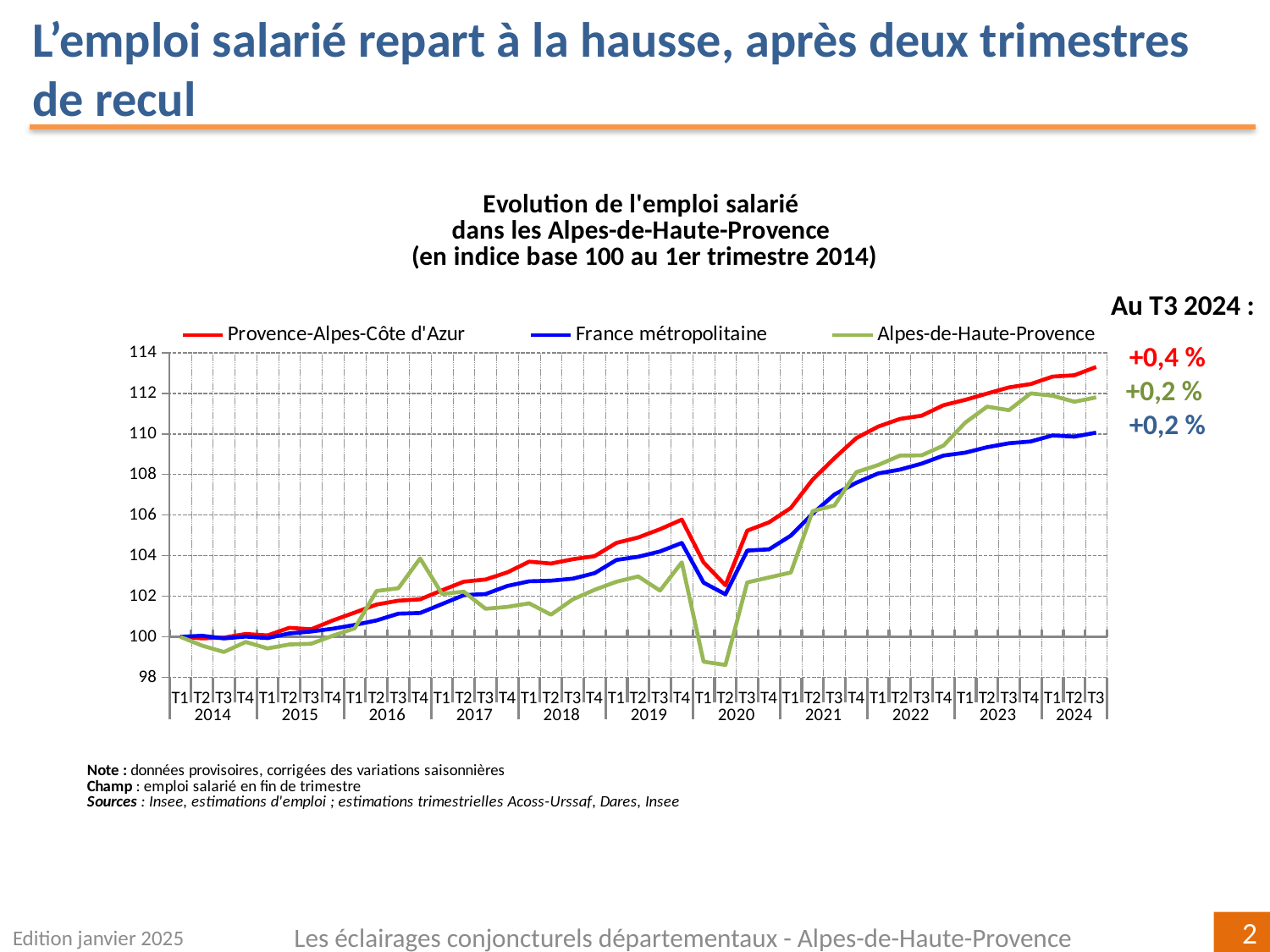
Is the value for Provence-Alpes-Côte d'Azur at T3 2024 greater or less than 112? greater At T3 2024, which is higher: Provence-Alpes-Côte d'Azur or France métropolitaine? Provence-Alpes-Côte d'Azur Which series has the lowest value at T2 2020? Alpes-de-Haute-Provence How many series does the legend list? 3 Is the value for France métropolitaine at T3 2024 greater or less than 112? less Which series has the highest value at T3 2024? Provence-Alpes-Côte d'Azur Which three series are listed in the legend? Provence-Alpes-Côte d'Azur, France métropolitaine, Alpes-de-Haute-Provence Overall, do the series rise or fall from T1 2014 to T3 2024? rise What kind of chart is shown on the slide? line chart Is the value for Alpes-de-Haute-Provence at T1 2020 greater or less than 100? less According to the annotation 'Au T3 2024', what is the quarterly change shown for Provence-Alpes-Côte d'Azur? +0,4 % What is the title of the chart? Evolution de l'emploi salarié dans les Alpes-de-Haute-Provence (en indice base 100 au 1er trimestre 2014)